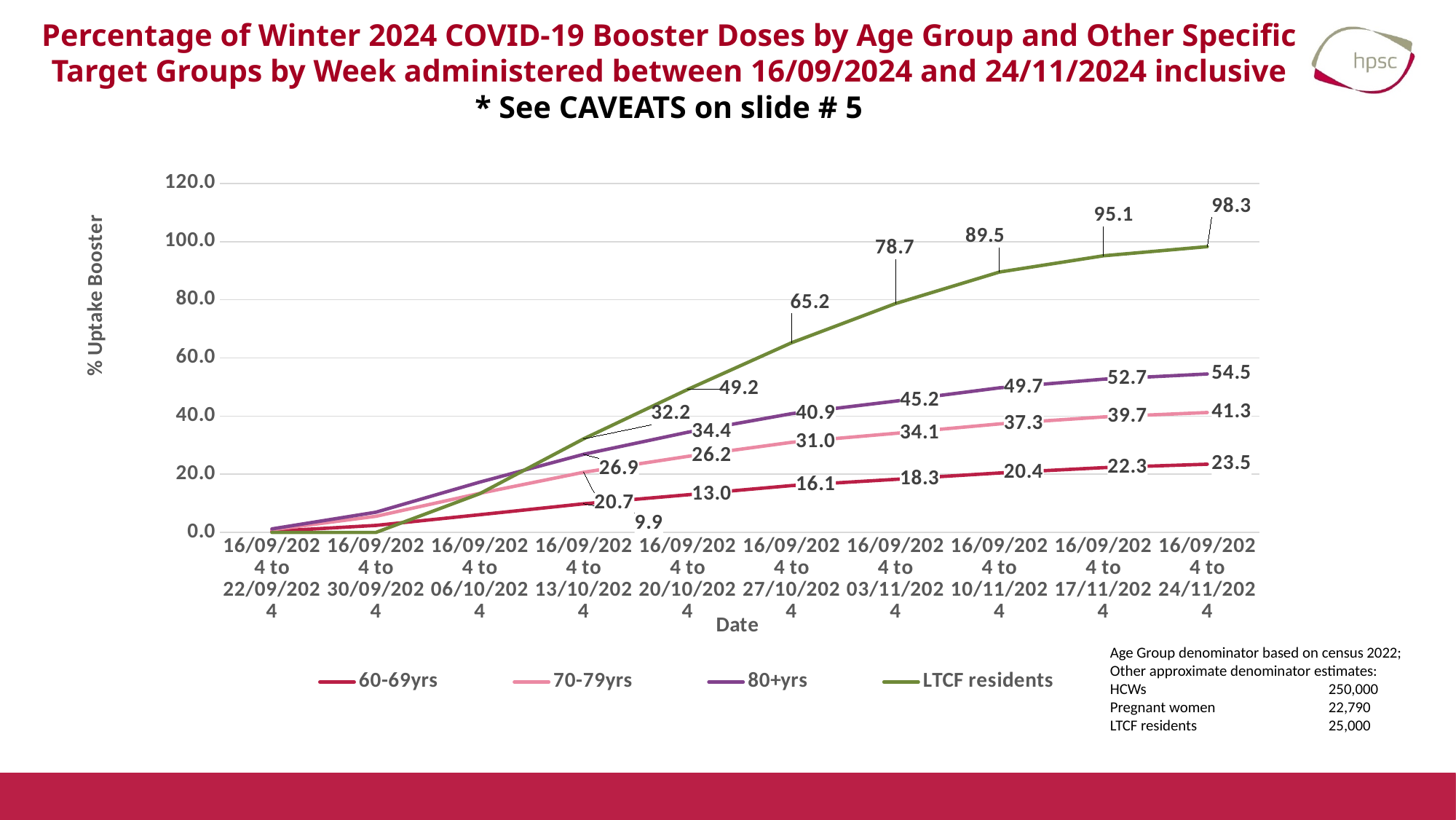
What is the % uptake for the 60-69yrs group for the period 16/09/2024 to 03/11/2024? 18.3 How many weekly periods are shown on the x axis? 10 What type of chart is shown on the slide? line chart What is the % uptake for LTCF residents for the period 16/09/2024 to 24/11/2024? 98.3 Which group has the highest % uptake for the period 16/09/2024 to 24/11/2024? LTCF residents Which group has the lowest % uptake for the period 16/09/2024 to 24/11/2024? 60-69yrs What is the difference between the 80+yrs and 70-79yrs % uptake for the period 16/09/2024 to 24/11/2024? 13.2 Does the LTCF residents line rise or fall across the periods shown? rise What is the % uptake for the 70-79yrs group for the period 16/09/2024 to 27/10/2024? 31.0 Which is larger for the period 16/09/2024 to 10/11/2024: the 80+yrs value or the 70-79yrs value? 80+yrs How many series does the legend list? 4 What is the % uptake for the 80+yrs group for the period 16/09/2024 to 24/11/2024? 54.5